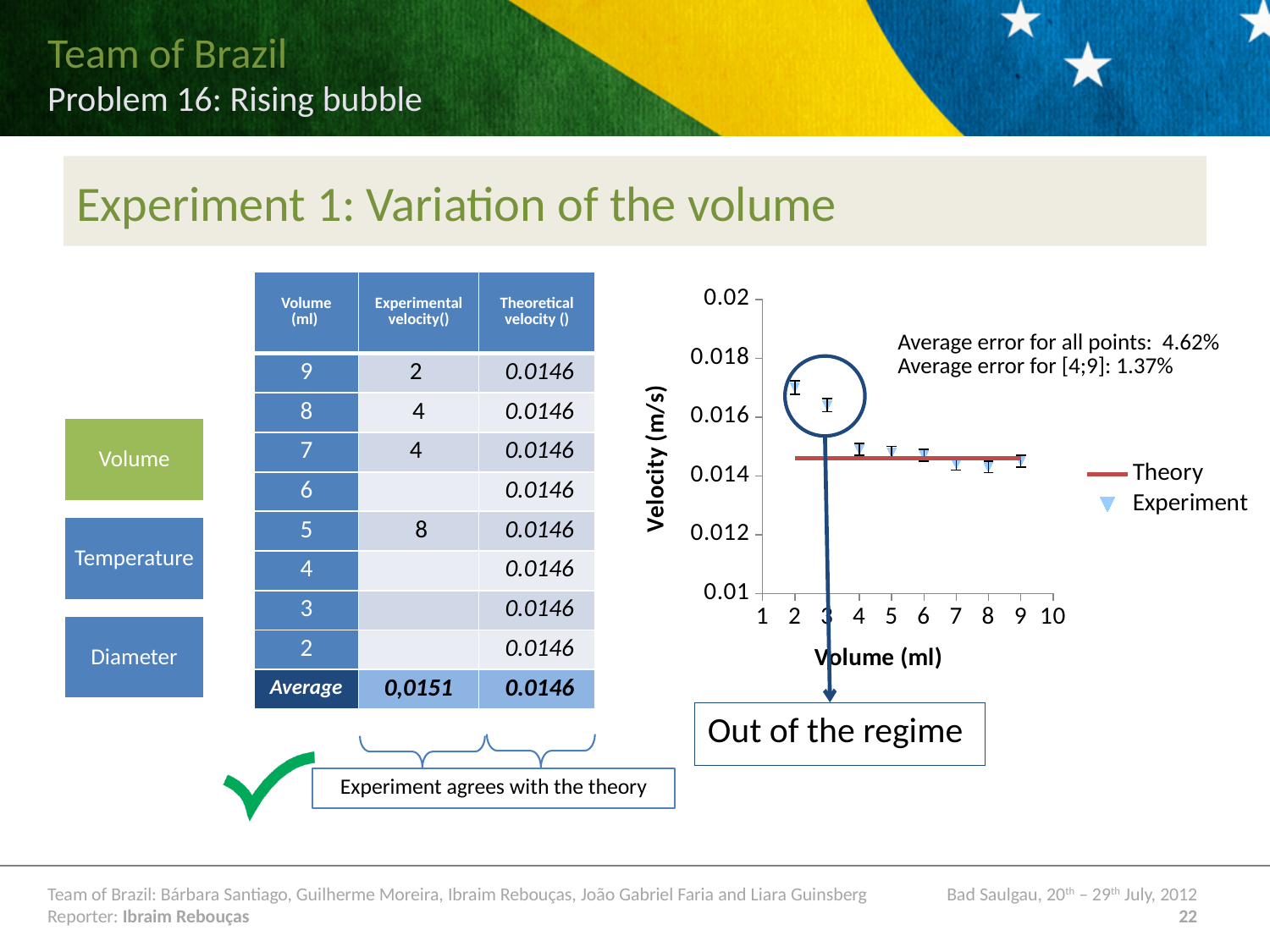
What kind of chart is shown on the slide? Scatter chart with a line At which volume is the Experiment velocity highest? 2 How many Experiment data points are plotted on the chart? 8 How many series does the chart legend list? 2 Do the Experiment velocities generally rise or fall as volume increases along the x axis? fall Is the Experiment velocity at a volume of 2 ml greater or less than 0.018? less Which is larger, the Experiment velocity at 2 ml or at 8 ml? 2 ml What is the label of the chart's y axis? Velocity (m/s) Is the Experiment velocity at a volume of 7 ml greater or less than 0.016? less What are the two entries in the chart legend? Theory and Experiment Is the Theory line greater or less than 0.012? greater